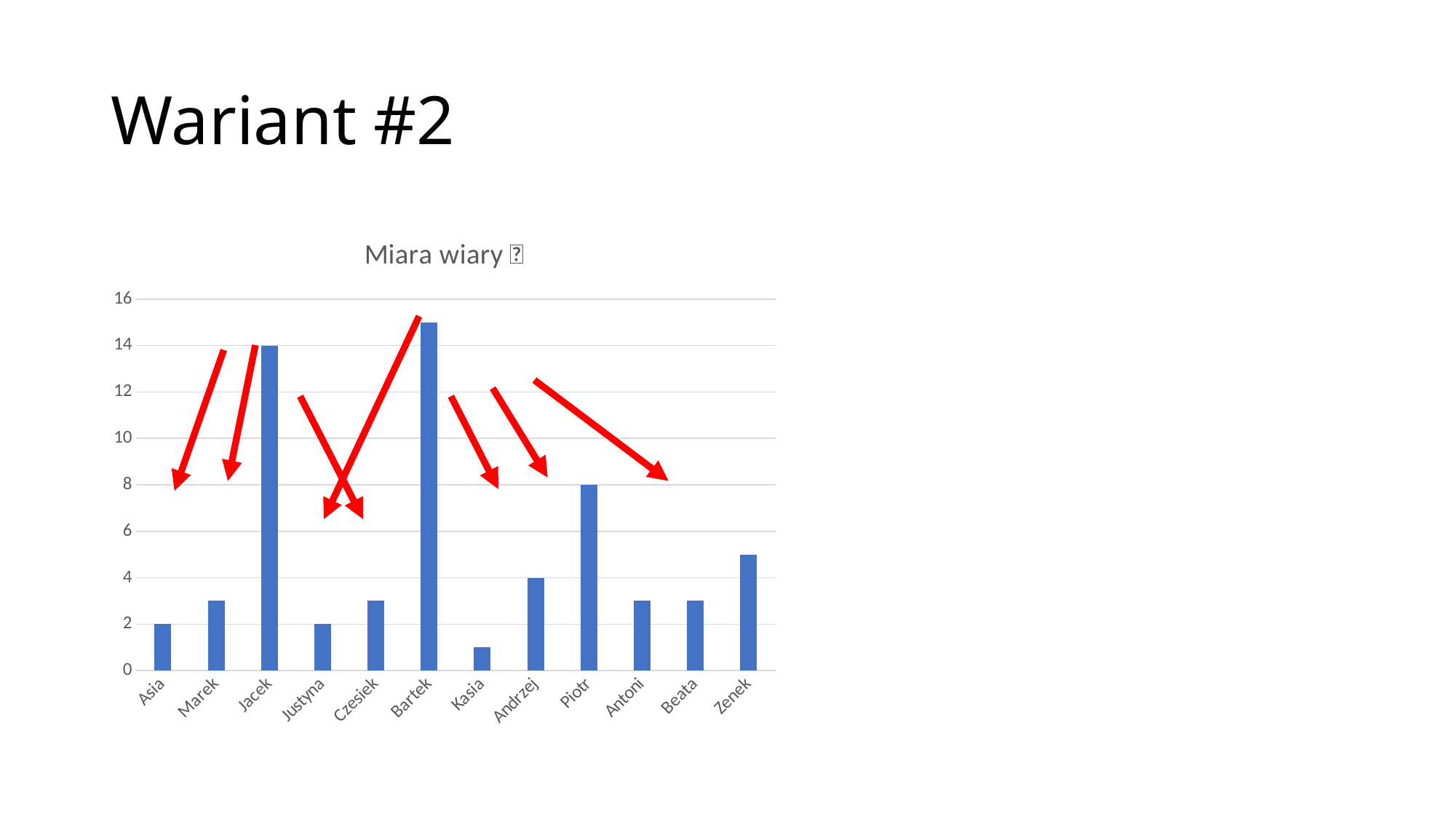
Is the value for Bartek greater or less than 14? greater What is the difference between the values for Jacek and Piotr? 6 Which is larger, the value for Piotr or the value for Zenek? Piotr Which person has the lowest value in the chart? Kasia Which person has the highest value in the chart? Bartek How many people (categories) are shown on the x axis of the chart? 12 What is the value for Piotr? 8 What is the value for Jacek? 14 Is the value for Zenek greater or less than 6? less What kind of chart is shown on the slide? bar chart What is the value for Andrzej? 4 What colour are the bars in the chart? blue